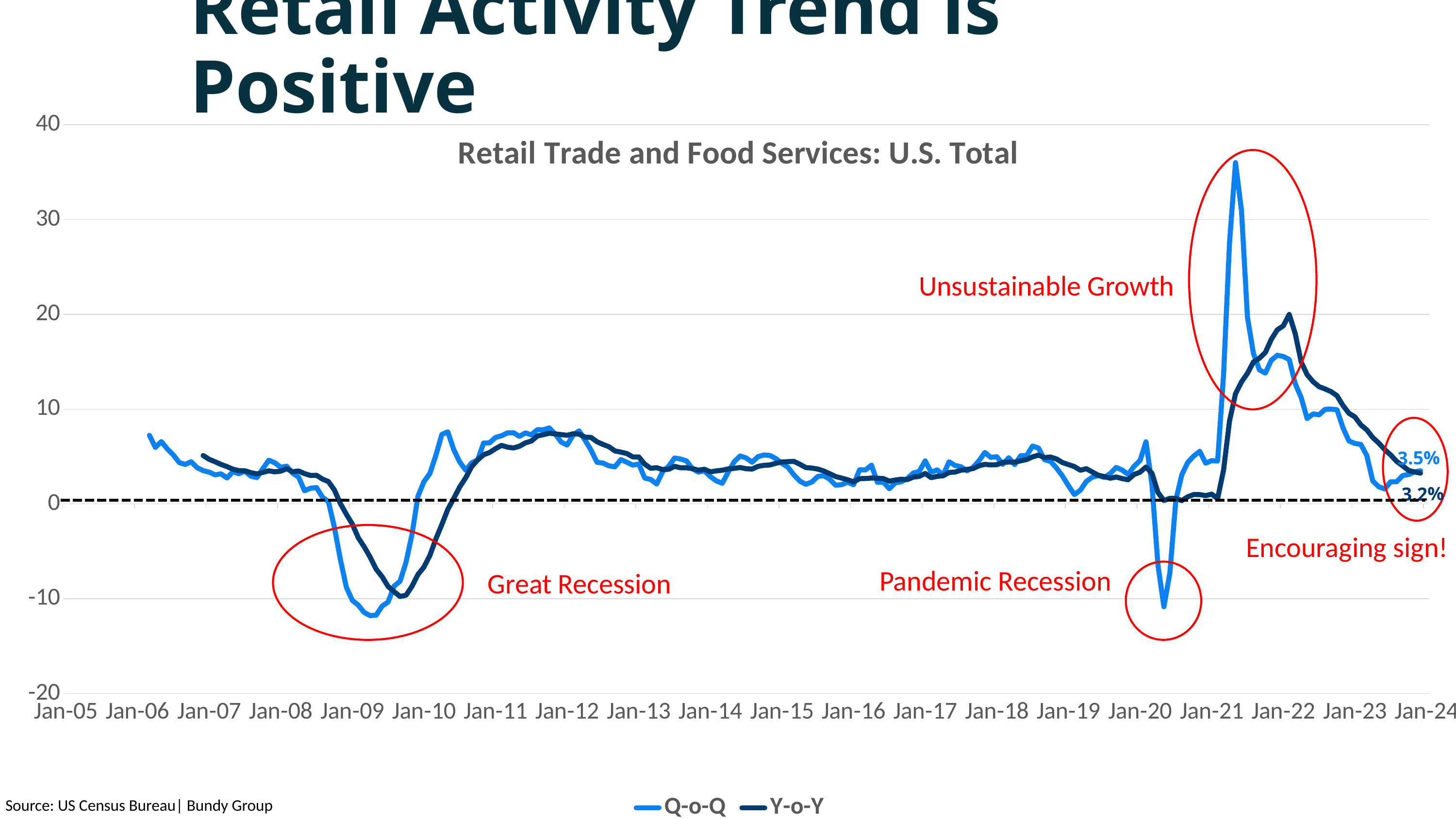
Does the Y-o-Y series rise or fall between Jan-22 and Jan-24? Fall What is the title of the chart? Retail Trade and Food Services: U.S. Total Around Jan-22, which series has the larger value, Q-o-Q or Y-o-Y? Y-o-Y What is the difference between the two values labelled at the right end of the chart, 3.5% and 3.2%? 0.3% What kind of chart is shown on the slide? Line chart Which series reaches the lowest point on the chart? Q-o-Q What two values are labelled at the right end of the lines near Jan-24? 3.5% and 3.2% Is the peak value of the Q-o-Q series around Jan-21 greater or less than 30? greater What are the names of the two series in the legend? Q-o-Q and Y-o-Y Which series reaches the highest peak on the chart? Q-o-Q Is the lowest value of the Q-o-Q series during the Great Recession greater or less than -10? less How many series does the chart legend list? 2